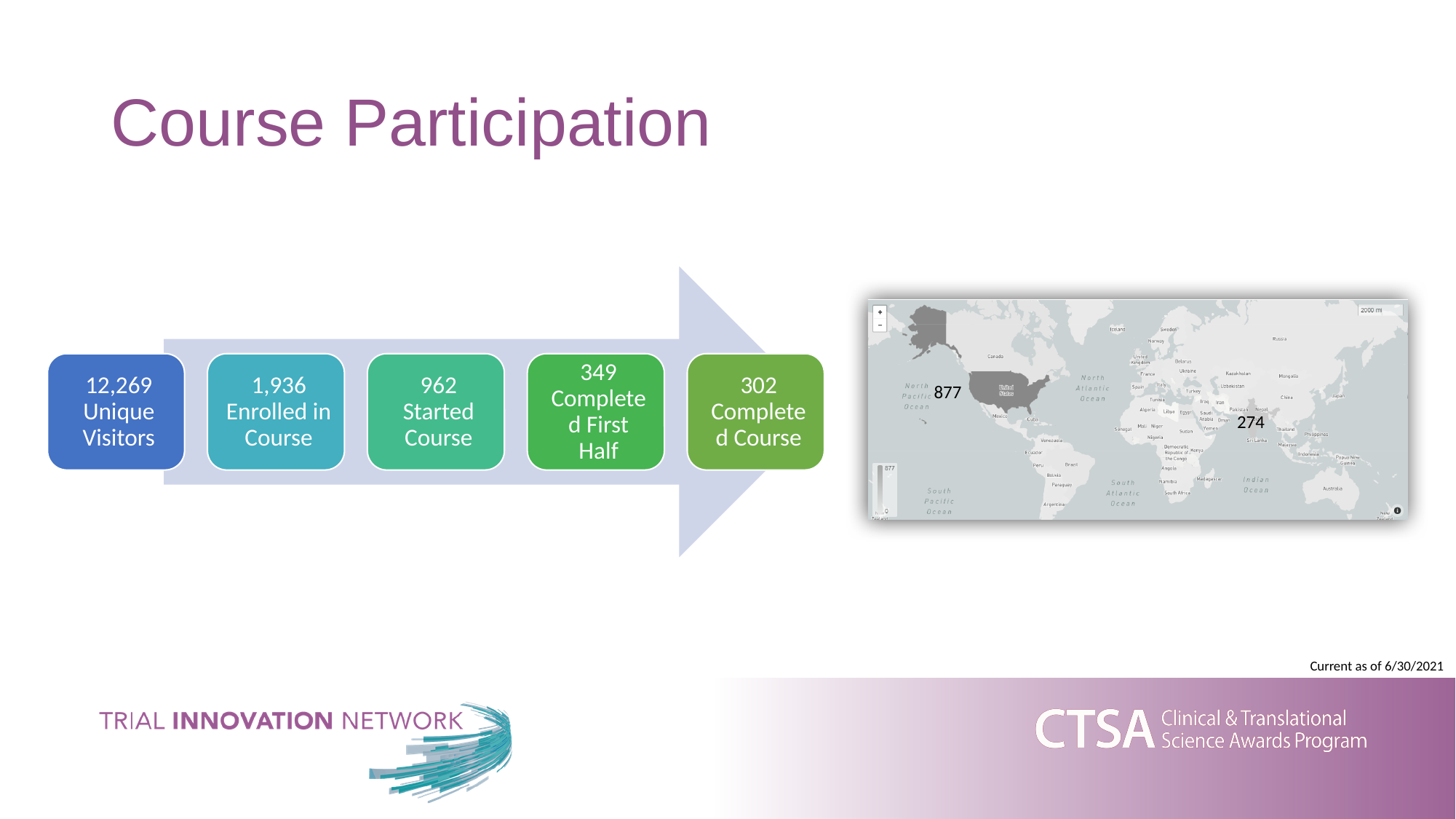
On the map chart, is the value for India greater or less than 300? less In the course participation funnel diagram, how many Unique Visitors are shown? 12,269 What kind of chart is shown on the right side of the slide? Map chart How many stages are shown in the course participation funnel diagram? 5 In the course participation funnel diagram, how many people Completed Course? 302 In the course participation funnel diagram, what is the difference between Started Course (962) and Completed First Half (349)? 613 On the map chart, what is the maximum value shown on the colour scale legend? 877 In the course participation funnel diagram, how many people Enrolled in Course? 1,936 On the map chart, what value is labelled near India? 274 On the map chart, what is the difference between the United States value (877) and the India value (274)? 603 On the map chart, which labelled country has the higher value, the United States or India? United States On the map chart, what value is labelled for the United States? 877